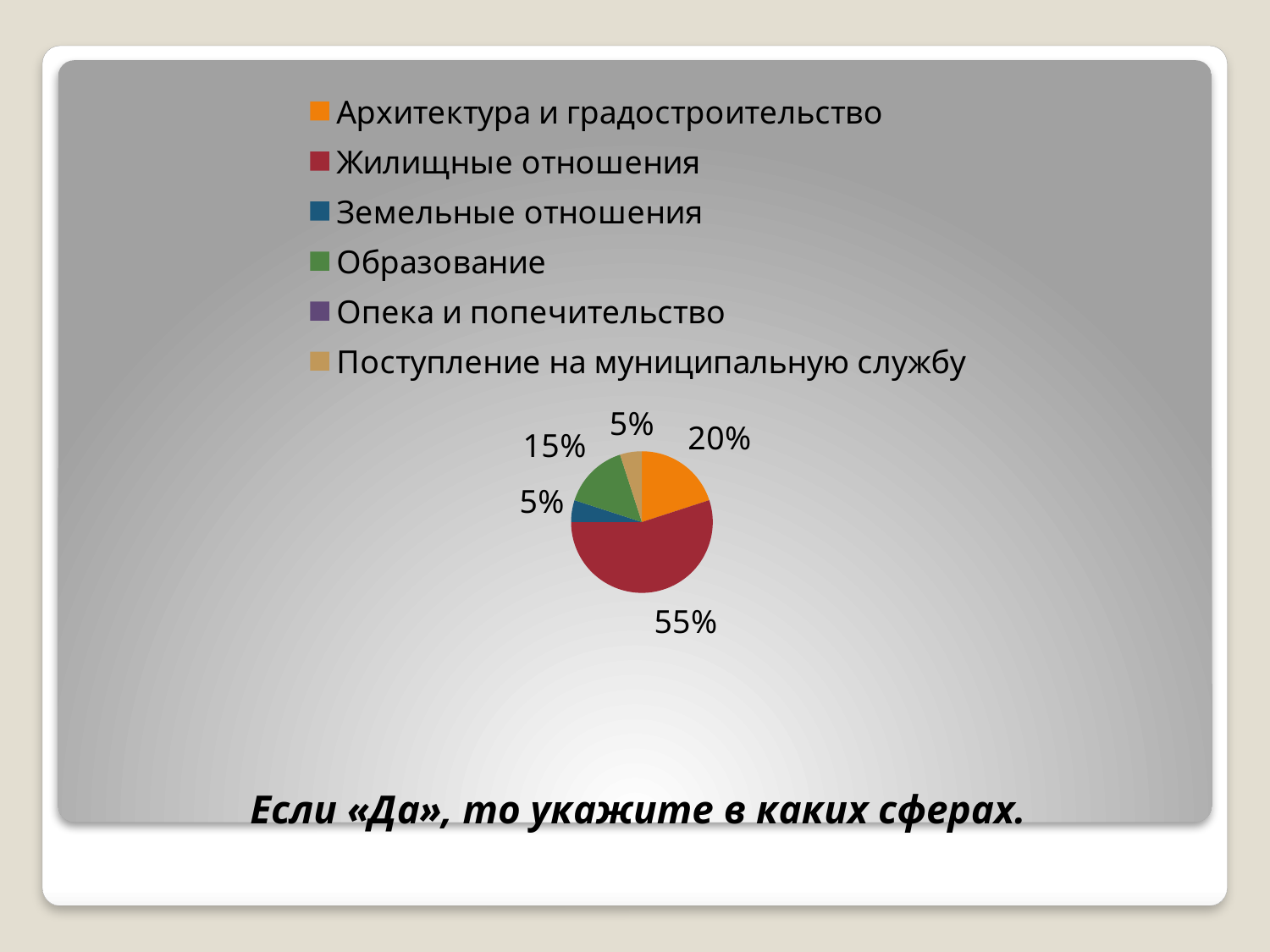
What share of the pie does "Земельные отношения" have? 5% Which is larger: the slice for "Архитектура и градостроительство" or the slice for "Образование"? Архитектура и градостроительство What share of the pie does "Жилищные отношения" have? 55% What is the difference between the share for "Жилищные отношения" and the share for "Архитектура и градостроительство"? 35% What share of the pie does "Образование" have? 15% What colour is the slice for "Жилищные отношения"? red How many entries does the legend list? 6 What share of the pie does "Поступление на муниципальную службу" have? 5% What text appears below the chart on the slide? Если «Да», то укажите в каких сферах. What share of the pie does "Архитектура и градостроительство" have? 20% Which category has the largest slice of the pie? Жилищные отношения What kind of chart is shown on the slide? pie chart